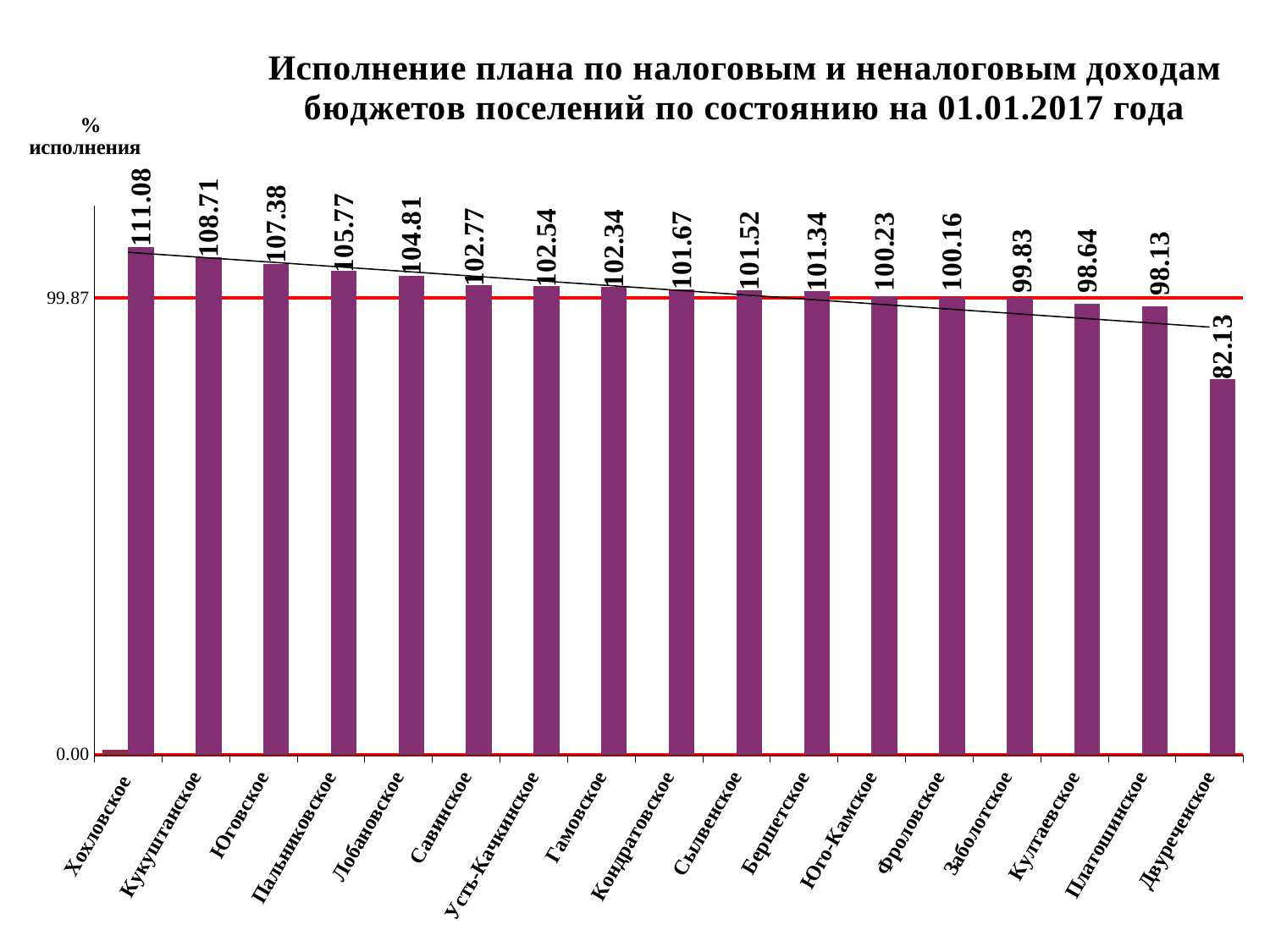
What is the value for Двуреченское? 82.13 Which category has the highest value? Хохловское Which category has the lowest value? Двуреченское What is the value for Заболотское? 99.83 How many categories are shown on the x axis? 17 What is the value for Гамовское? 102.34 Which is larger, the value for Юговское or the value for Лобановское? Юговское What kind of chart is this? bar chart What value is marked by the horizontal red line on the y axis? 99.87 What is the difference between the values for Платошинское and Двуреченское? 16.00 What is the value for Хохловское? 111.08 What is the difference between the values for Хохловское and Кукуштанское? 2.37